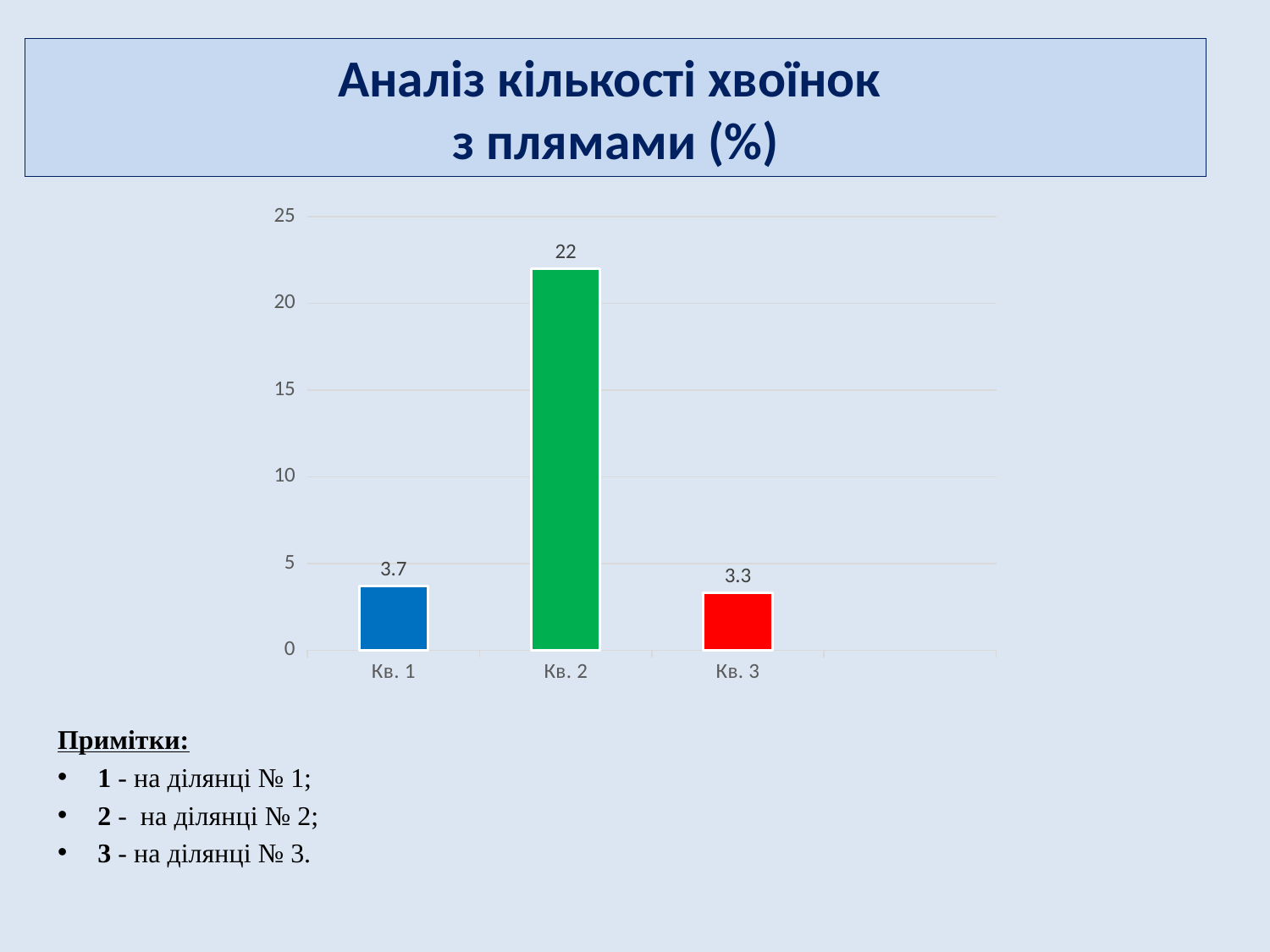
Is the value for Кв. 2 greater or less than 20? greater Which category has the highest value? Кв. 2 What is the value for Кв. 2? 22 How many categories are shown on the x axis? 3 What is the value for Кв. 3? 3.3 What is the difference between the values for Кв. 2 and Кв. 1? 18.3 Which category has the lowest value? Кв. 3 What kind of chart is shown on the slide? bar chart What colour is the bar for Кв. 2? green What is the value for Кв. 1? 3.7 What is the difference between the values for Кв. 1 and Кв. 3? 0.4 Which is larger, the value for Кв. 1 or the value for Кв. 3? Кв. 1